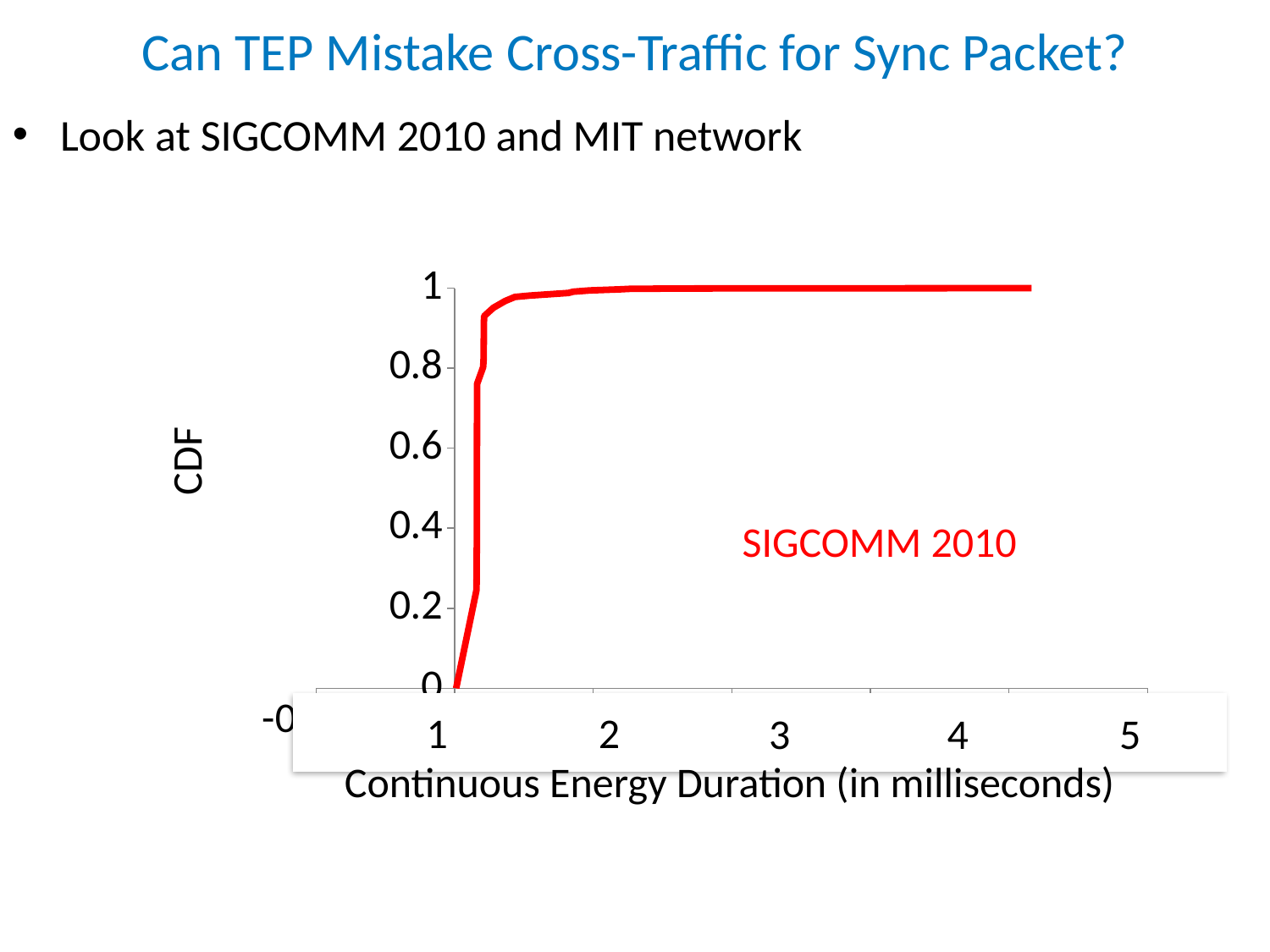
What is the label on the x axis of the chart? Continuous Energy Duration (in milliseconds) How many data series are plotted on the chart? 1 Is the CDF value at a Continuous Energy Duration of 2 milliseconds greater or less than 0.8? greater Is the CDF value at a Continuous Energy Duration of 3 milliseconds greater or less than 0.6? greater What kind of chart is shown on the slide? line chart What is the label on the y axis of the chart? CDF Does the CDF curve rise or fall as Continuous Energy Duration increases along the x axis? rise Is the CDF value at a Continuous Energy Duration of 4 milliseconds greater or less than 0.8? greater Which is larger, the CDF value at 2 milliseconds or the CDF value at 4 milliseconds? 4 milliseconds What is the highest tick value shown on the x axis of the chart? 5